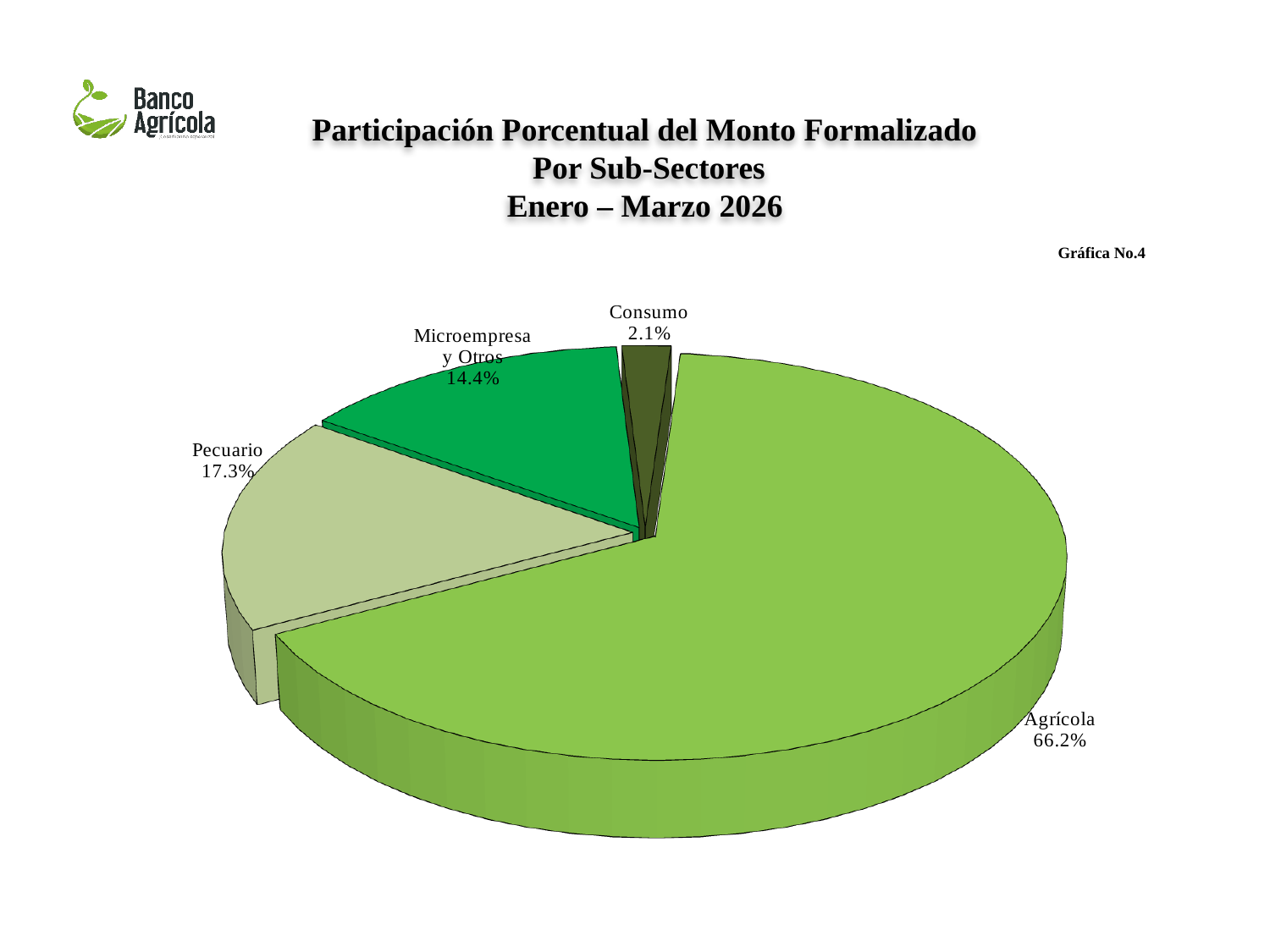
What is the difference in percentage points between Agrícola and Pecuario? 48.9 How many slices does the pie chart have? 4 What share of the pie does Agrícola hold? 66.2% Which sub-sector has the smallest share? Consumo What is the difference in percentage points between Pecuario and Microempresa y Otros? 2.9 What is the value shown for Microempresa y Otros? 14.4% Which is larger, Pecuario or Microempresa y Otros? Pecuario What is the value shown for Pecuario? 17.3% What period does the chart title cover? Enero – Marzo 2026 What is the value shown for Consumo? 2.1% Which sub-sector has the largest share? Agrícola What kind of chart is shown on the slide? Pie chart